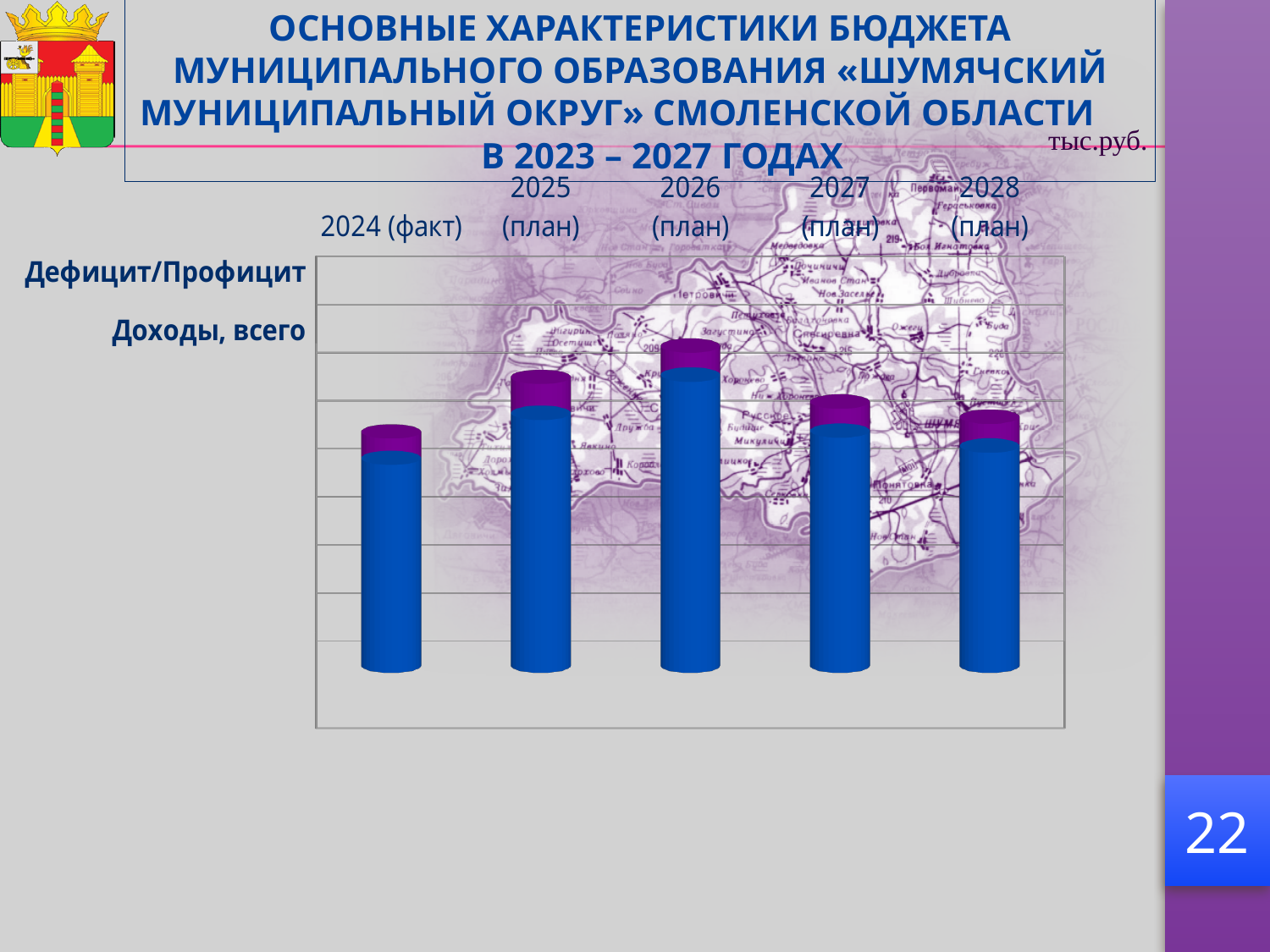
Which bar is taller, 2024 (факт) or 2028 (план)? 2028 (план) Which bar is taller, 2025 (план) or 2027 (план)? 2025 (план) What unit of measurement is indicated for the chart? тыс.руб. Which year has the shortest bar on the chart? 2024 (факт) Do the bars rise or fall from 2026 (план) to 2028 (план)? fall How many year categories are plotted on the chart? 5 What kind of chart is shown on the slide? bar chart Do the bars rise or fall from 2024 (факт) to 2026 (план)? rise Which year has the tallest bar on the chart? 2026 (план)